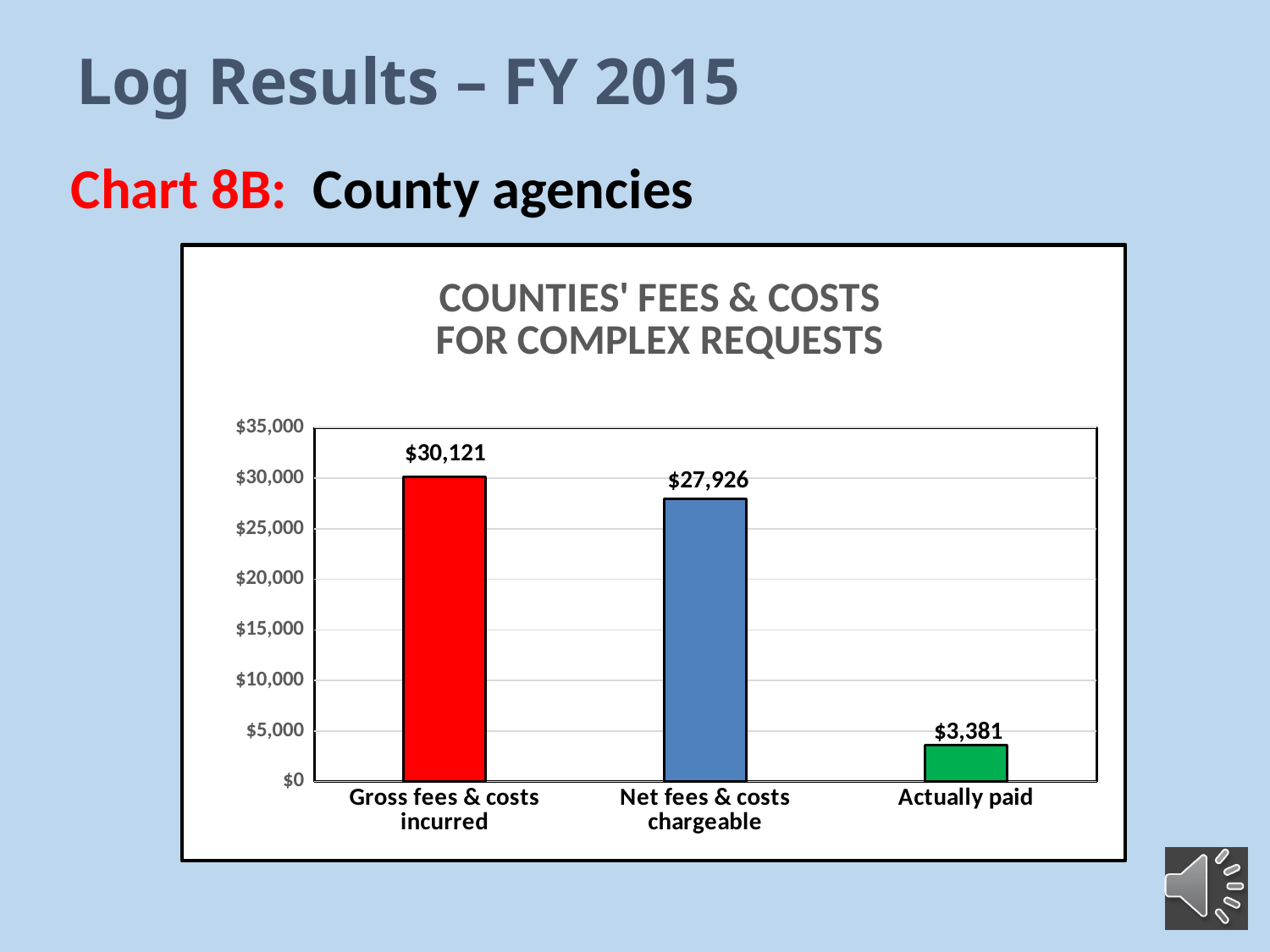
What is the title of the chart? COUNTIES' FEES & COSTS FOR COMPLEX REQUESTS How many categories are shown in the chart? 3 Which is larger, Net fees & costs chargeable or Actually paid? Net fees & costs chargeable Which category has the lowest value? Actually paid What is the difference between Gross fees & costs incurred and Net fees & costs chargeable? $2,195 What is the difference between Net fees & costs chargeable and Actually paid? $24,545 What is the value for Actually paid? $3,381 Is the value for Actually paid greater or less than $5,000? less What is the value for Net fees & costs chargeable? $27,926 What kind of chart is shown? bar chart What is the value for Gross fees & costs incurred? $30,121 Which category has the highest value? Gross fees & costs incurred